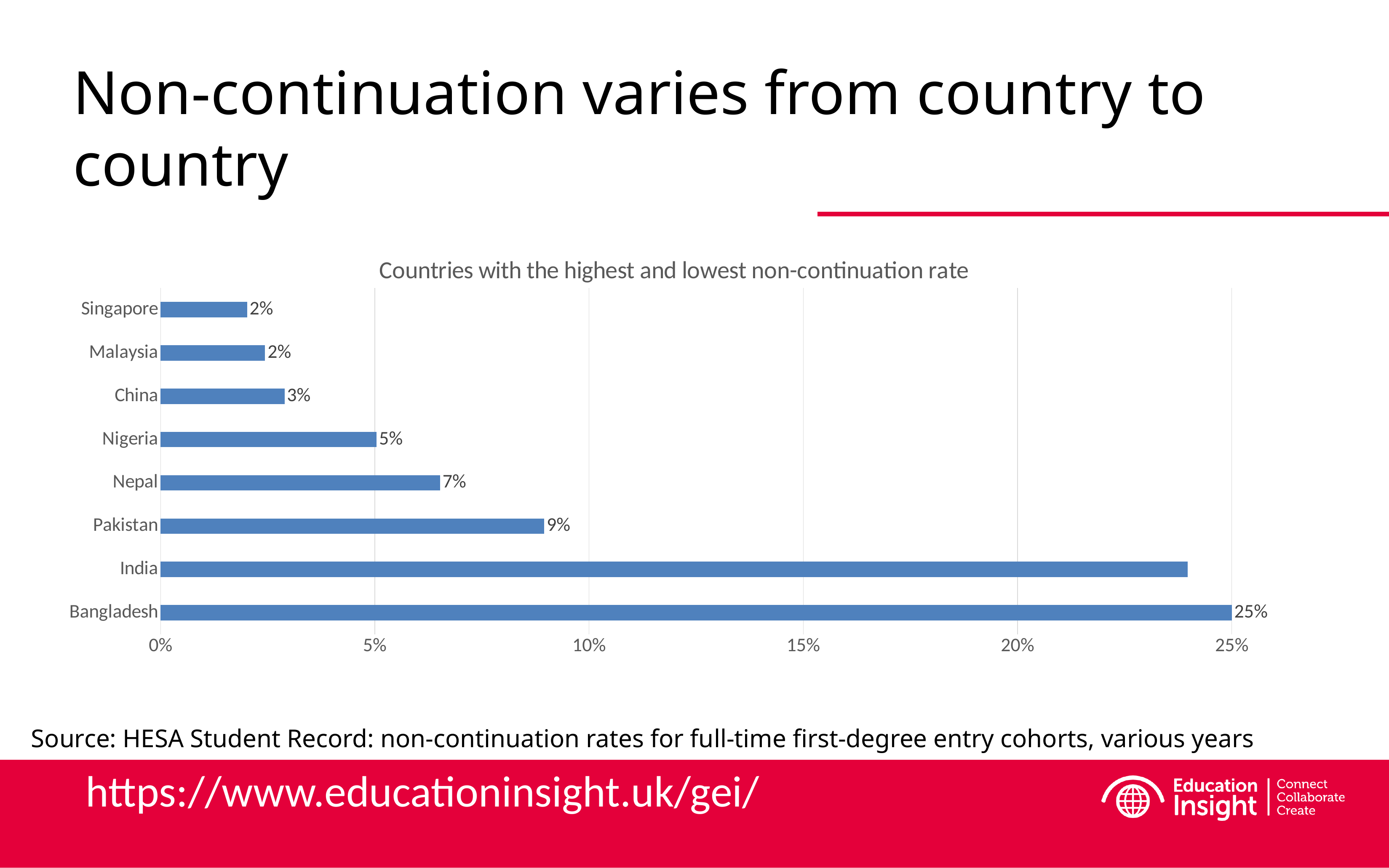
What type of chart is shown on the slide? Bar chart What is the difference between the non-continuation rates of Nepal and China? 4% What is the non-continuation rate for Pakistan? 9% Which country has the highest non-continuation rate? Bangladesh What is the non-continuation rate for Bangladesh? 25% What is the non-continuation rate for China? 3% What is the difference between the non-continuation rates of Bangladesh and Pakistan? 16% Which has a higher non-continuation rate, Nigeria or Nepal? Nepal Is the non-continuation rate for India greater or less than 20%? greater What is the non-continuation rate for Nepal? 7% How many countries are shown in the chart? 8 What is the non-continuation rate for Nigeria? 5%